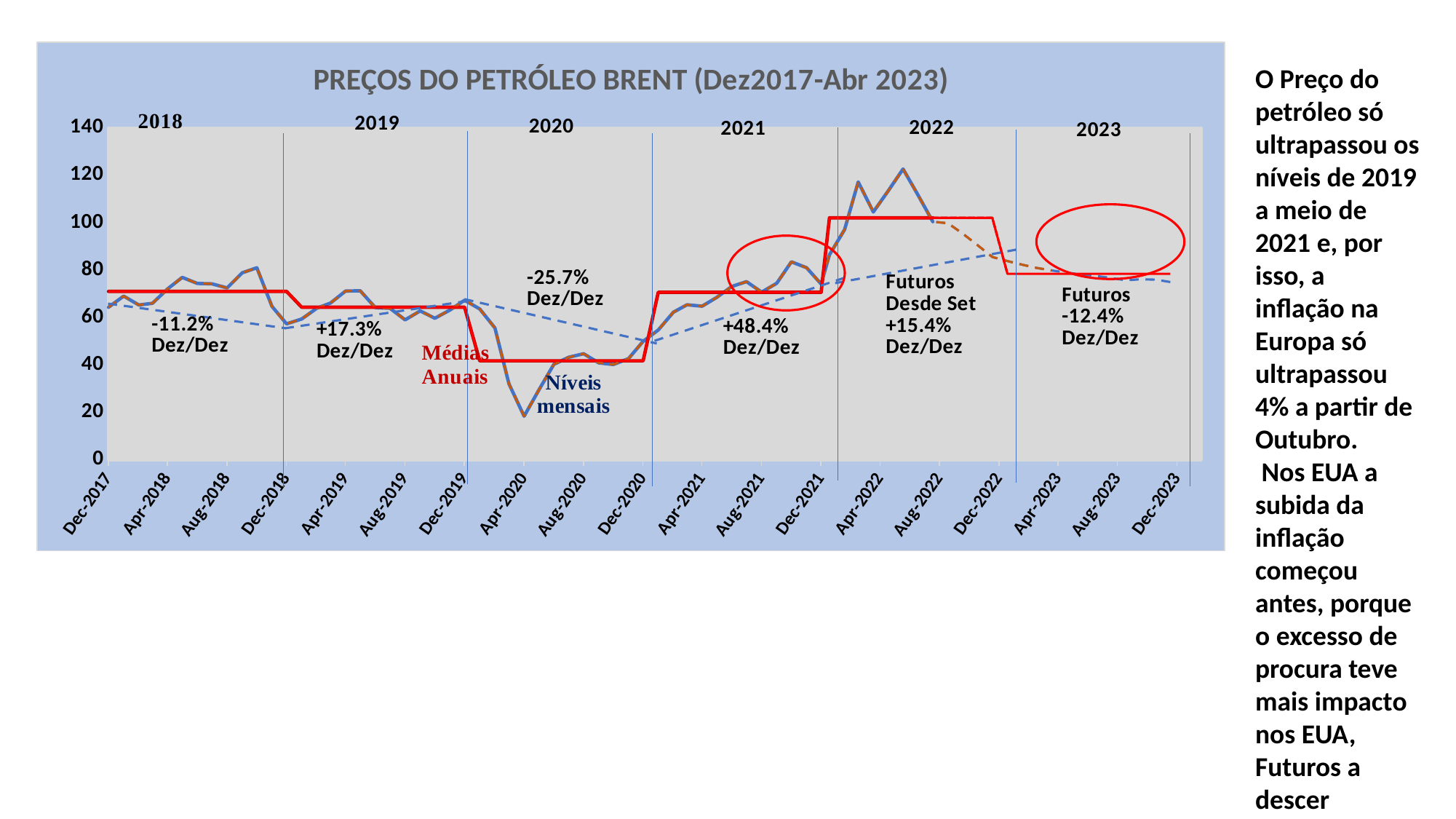
What Dez/Dez percentage change is annotated for 2018? -11.2% What Dez/Dez percentage change is annotated for the 2023 futures? -12.4% Which year has the largest annotated Dez/Dez percentage decrease? 2020 Is the annual average (Médias Anuais) for 2020 greater or less than 60? less What Dez/Dez percentage change is annotated for 2020? -25.7% Do the monthly levels rise or fall between Dec-2019 and Apr-2020? fall Which year has the largest annotated Dez/Dez percentage increase? 2021 What is the title of the chart? PREÇOS DO PETRÓLEO BRENT (Dez2017-Abr 2023) Is the monthly level for Apr-2020 greater or less than 40? less In which year does the monthly level reach its highest peak? 2022 What Dez/Dez percentage change is annotated for 2021? +48.4% What kind of chart is shown on the slide? line chart